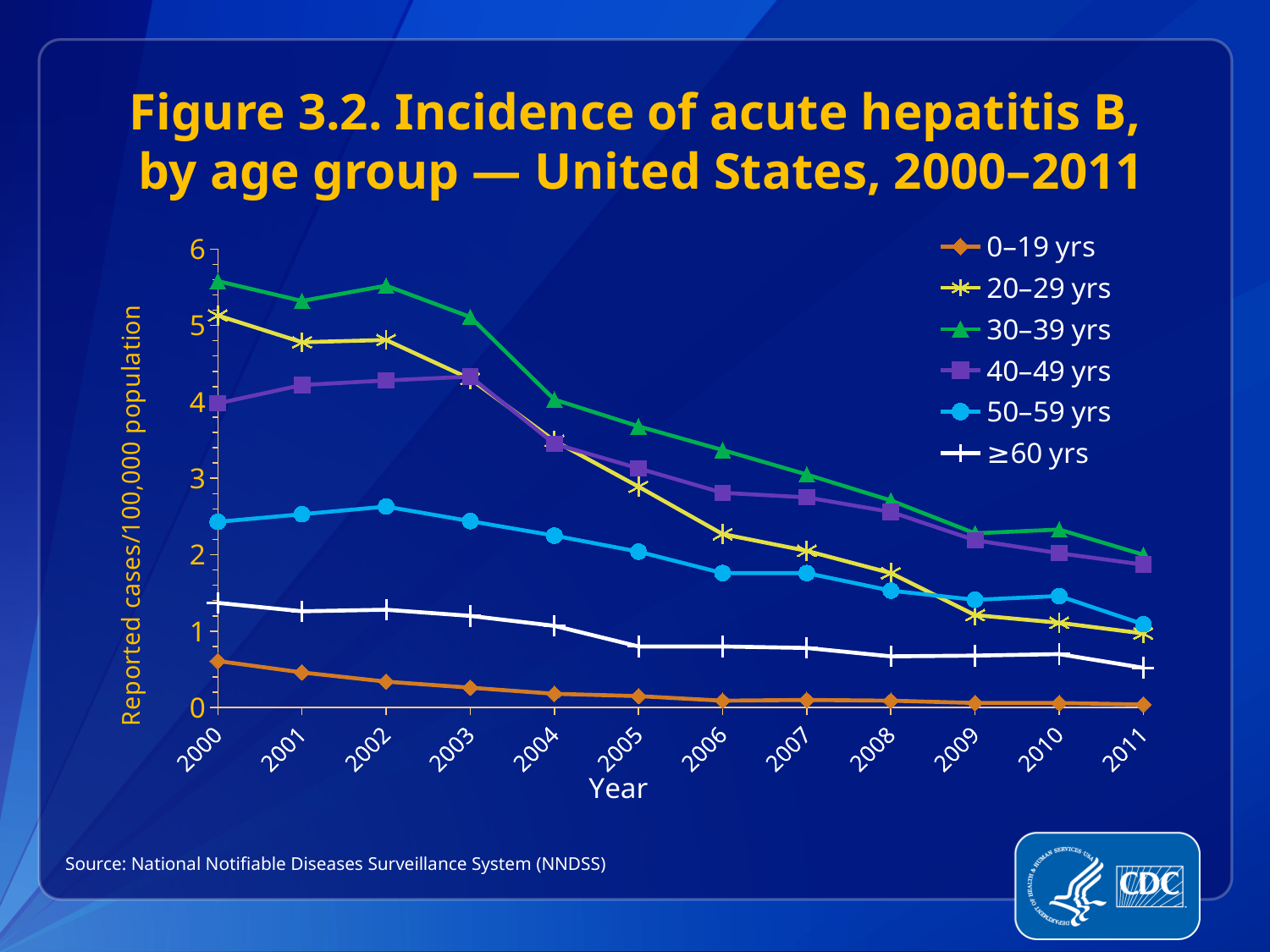
Is the value for 30–39 yrs in 2000 greater or less than 5? greater Is the value for ≥60 yrs in 2011 greater or less than 1? less What is the label of the y axis? Reported cases/100,000 population Is the value for 0–19 yrs in 2000 greater or less than 1? less How many years are plotted along the x axis? 12 What kind of chart is shown on the slide? line chart In 2005, which is larger: the value for 30–39 yrs or the value for 40–49 yrs? 30–39 yrs Which age group has the lowest incidence in 2000? 0–19 yrs How many age-group series does the legend list? 6 Does the incidence for 30–39 yrs generally rise or fall from 2000 to 2011? fall Which age group has the highest incidence in 2000? 30–39 yrs